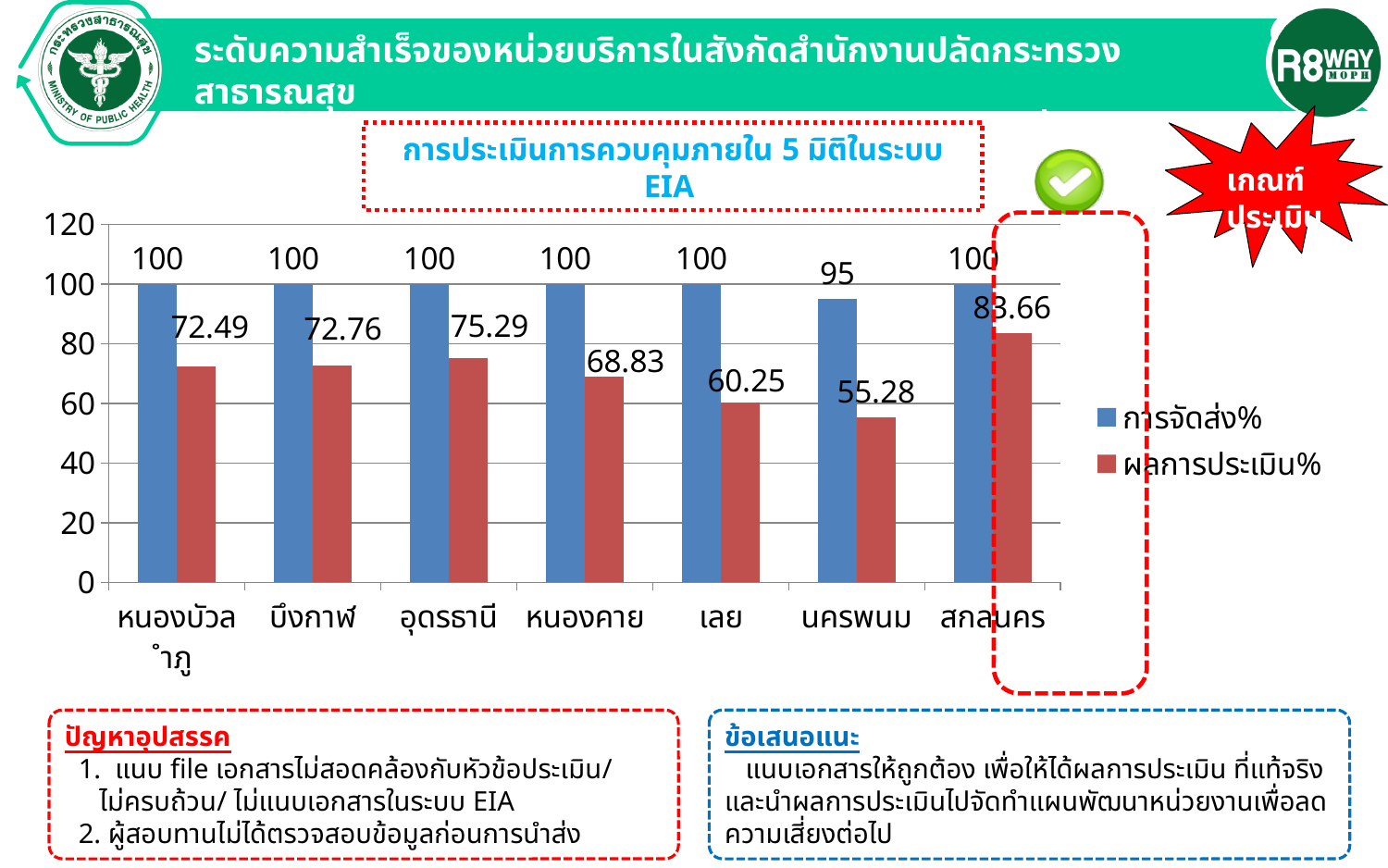
Which is larger, the ผลการประเมิน% value for หนองคาย or for เลย? หนองคาย What is the ผลการประเมิน% value for อุดรธานี? 75.29 What is the difference between the ผลการประเมิน% values for สกลนคร and นครพนม? 28.38 What is the การจัดส่ง% value for นครพนม? 95 Which province has the highest ผลการประเมิน% value? สกลนคร Which province has the lowest การจัดส่ง% value? นครพนม How many provinces are shown on the x axis of the chart? 7 Which province has the lowest ผลการประเมิน% value? นครพนม How many series does the chart legend list? 2 What kind of chart is shown on the slide? bar chart What is the ผลการประเมิน% value for สกลนคร? 83.66 Is the ผลการประเมิน% value for เลย greater or less than 80? less